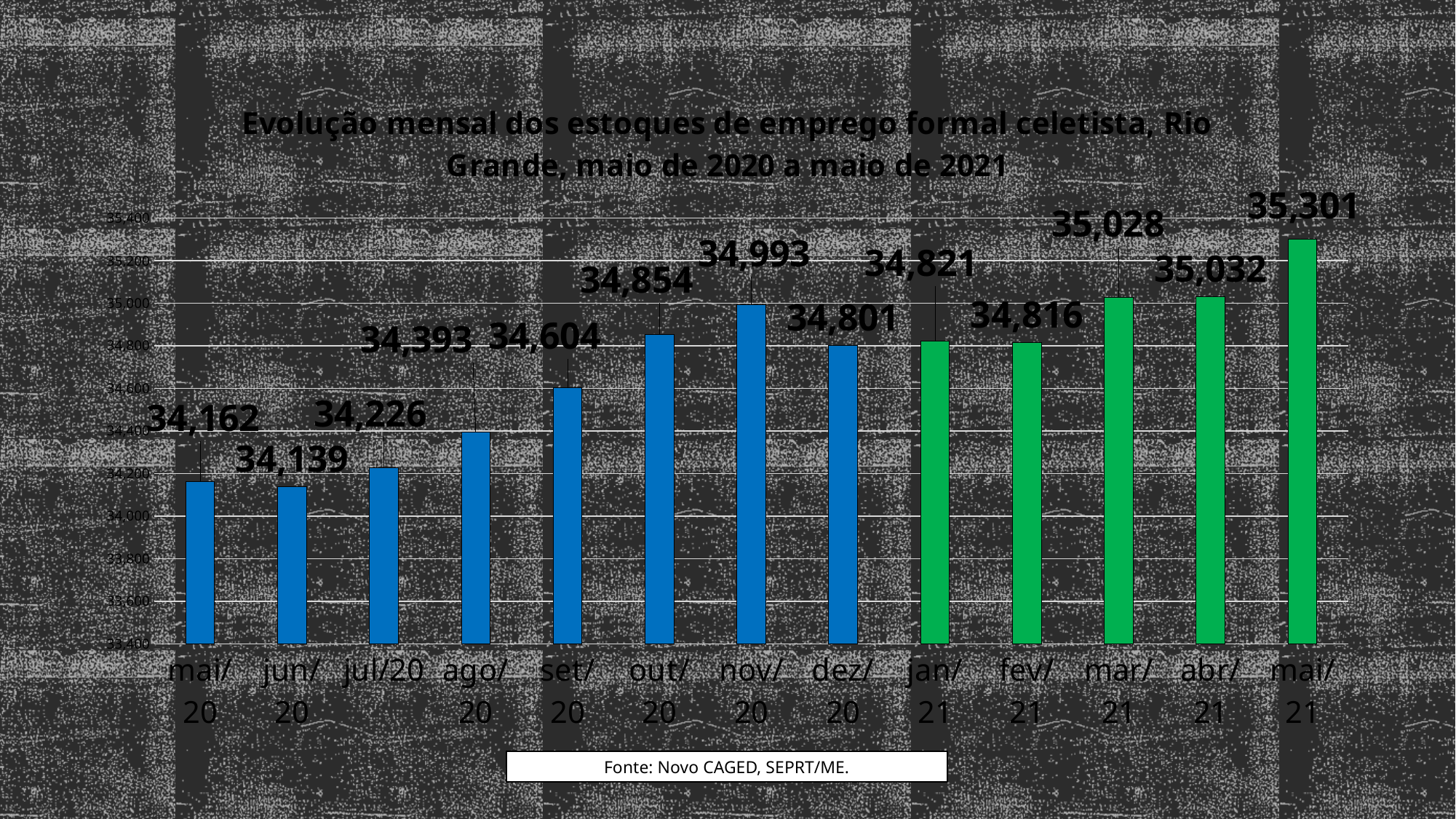
What is the value for mar/21? 35,028 What is the difference between the values for mai/21 and mai/20? 1,139 What is the value for nov/20? 34,993 What is the difference between the values for nov/20 and out/20? 139 Which month has the lowest value? jun/20 What kind of chart is shown on the slide? Bar chart Do the values generally rise or fall from mai/20 to mai/21? Rise What is the value for ago/20? 34,393 How many months are shown on the chart? 13 Which month has the highest value? mai/21 Which is larger, the value for nov/20 or the value for dez/20? nov/20 What colour are the bars for the 2021 months? Green